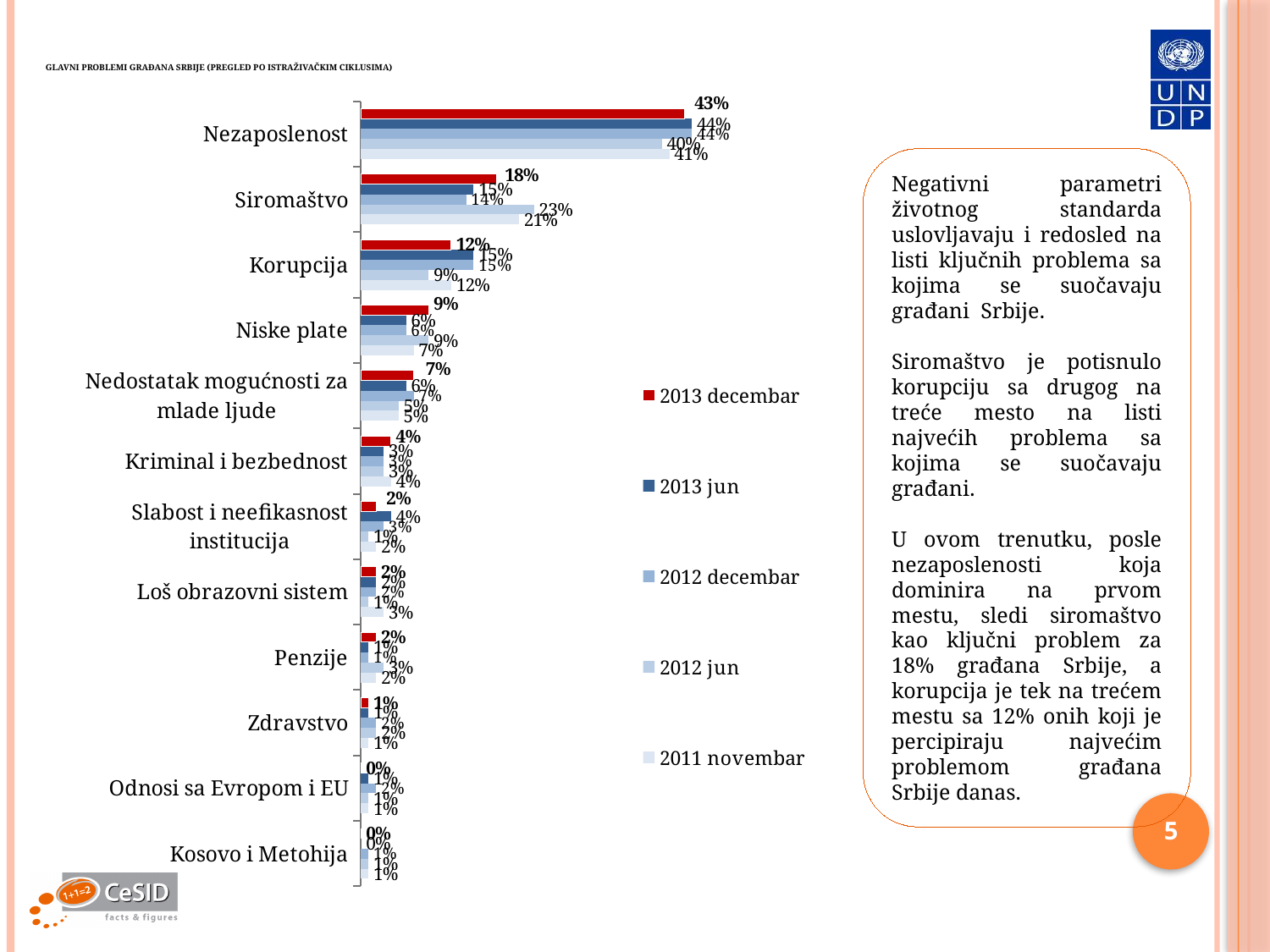
What is the value for Niske plate in the 2013 decembar series? 9% Which series is shown in red in the legend? 2013 decembar How many series does the legend list? 5 What is the value for Siromaštvo in the 2012 jun series? 23% In the 2013 decembar series, which is larger: Nedostatak mogućnosti za mlade ljude or Kriminal i bezbednost? Nedostatak mogućnosti za mlade ljude What kind of chart is shown on the slide? bar chart What is the value for Siromaštvo in the 2013 decembar series? 18% How many problem categories are plotted on the chart? 12 What is the difference between the 2013 decembar values for Siromaštvo and Korupcija? 6% Which category has the highest value in the 2013 decembar series? Nezaposlenost What is the value for Nezaposlenost in the 2013 decembar series? 43% What is the value for Korupcija in the 2013 decembar series? 12%